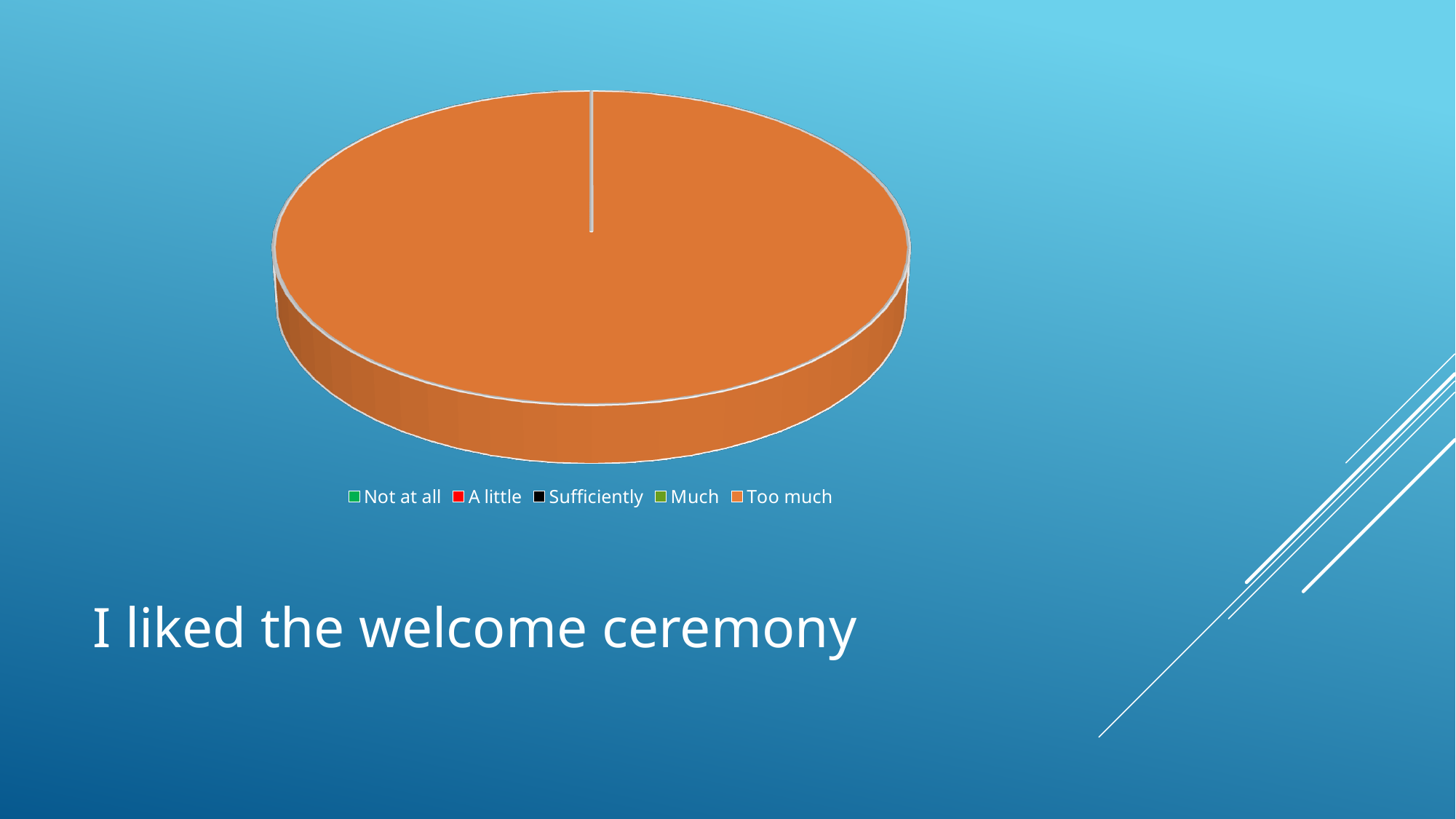
How many slices are visible in the pie chart? 1 Which is larger in the pie chart, 'Too much' or 'A little'? Too much What text appears below the pie chart on the slide? I liked the welcome ceremony Is the share of the pie for 'Too much' larger than the share for 'Not at all'? Yes What colour represents the 'Too much' category in the legend? orange Which category fills the entire pie chart? Too much What kind of chart is shown on the slide? pie chart How many categories does the legend of the pie chart list? 5 Which category has the largest share of the pie chart? Too much